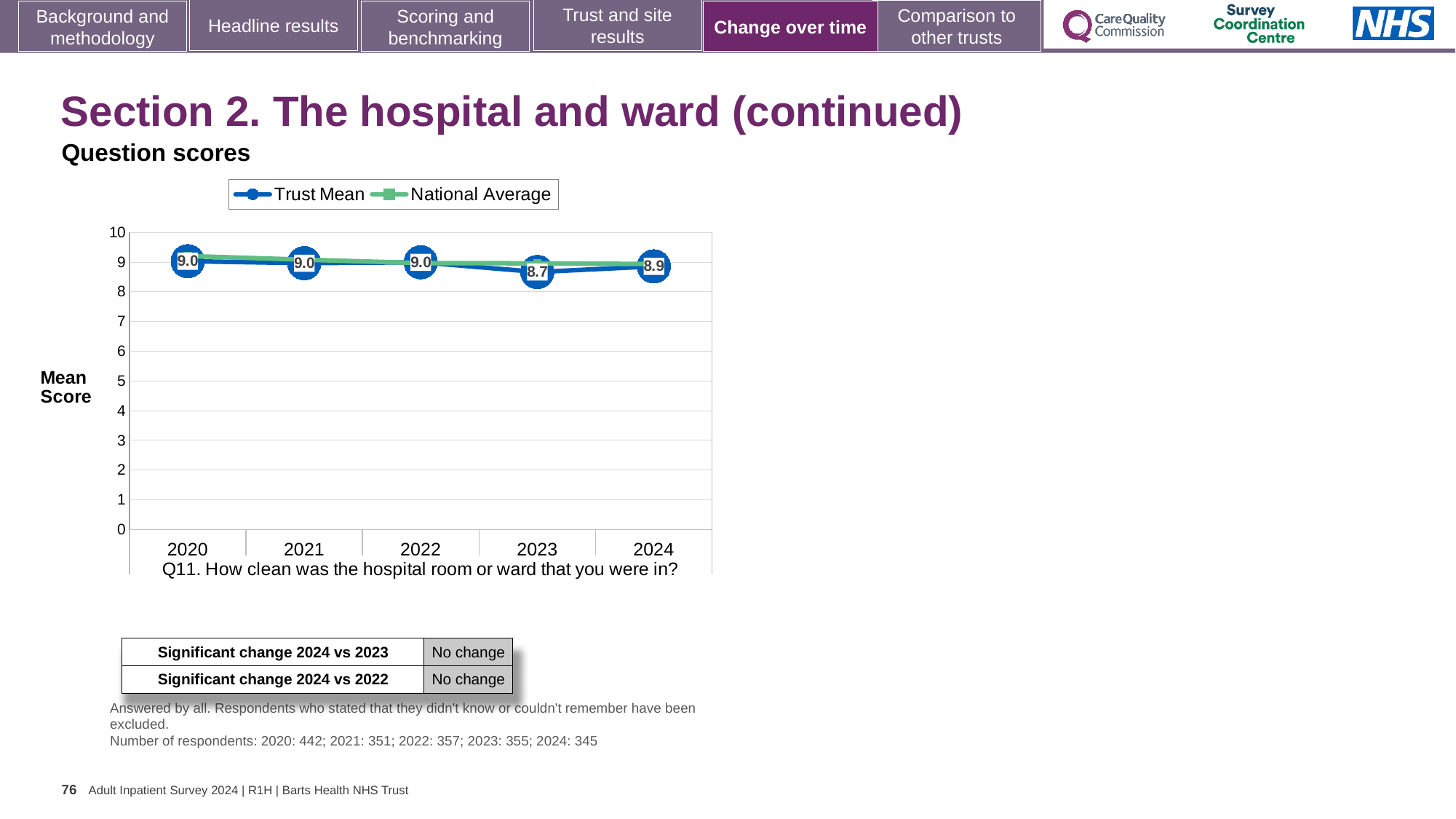
Which survey question does the chart show scores for? Q11. How clean was the hospital room or ward that you were in? What is the Trust Mean score for 2024? 8.9 In which year is the Trust Mean score lowest? 2023 What is the Trust Mean score for 2020? 9.0 Between 2022 and 2023, does the Trust Mean score rise or fall? Fall What kind of chart is shown on the slide? Line chart What is the difference between the Trust Mean scores for 2022 and 2023? 0.3 Which year has the larger Trust Mean score, 2023 or 2024? 2024 How many years are plotted on the x axis? 5 How many series does the legend list? 2 Is the National Average value for 2023 greater or less than 8? greater What is the Trust Mean score for 2023? 8.7